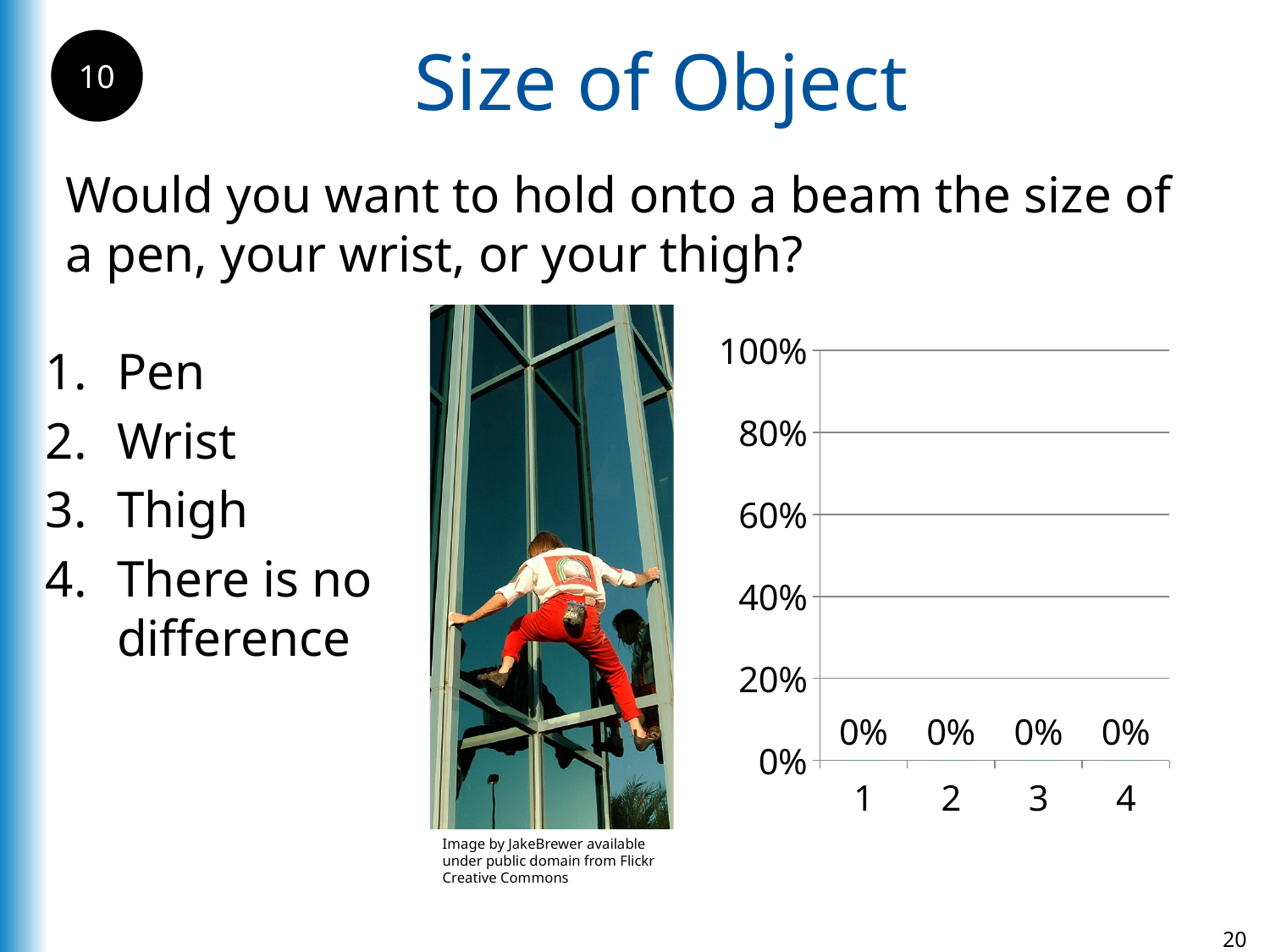
How many categories are shown on the x axis of the chart? 4 Is the value for category 4 greater or less than 40%? less What is the interval between the tick labels on the chart's y axis? 20% What is the difference between the values for category 1 and category 2? 0% Is the value for category 1 greater or less than 20%? less What is the highest value shown on the chart's y axis? 100% What is the value for category 4 in the bar chart? 0% What is the value for category 2 in the bar chart? 0% What kind of chart is shown on the slide? bar chart What is the value for category 3 in the bar chart? 0% What is the value for category 1 in the bar chart? 0%